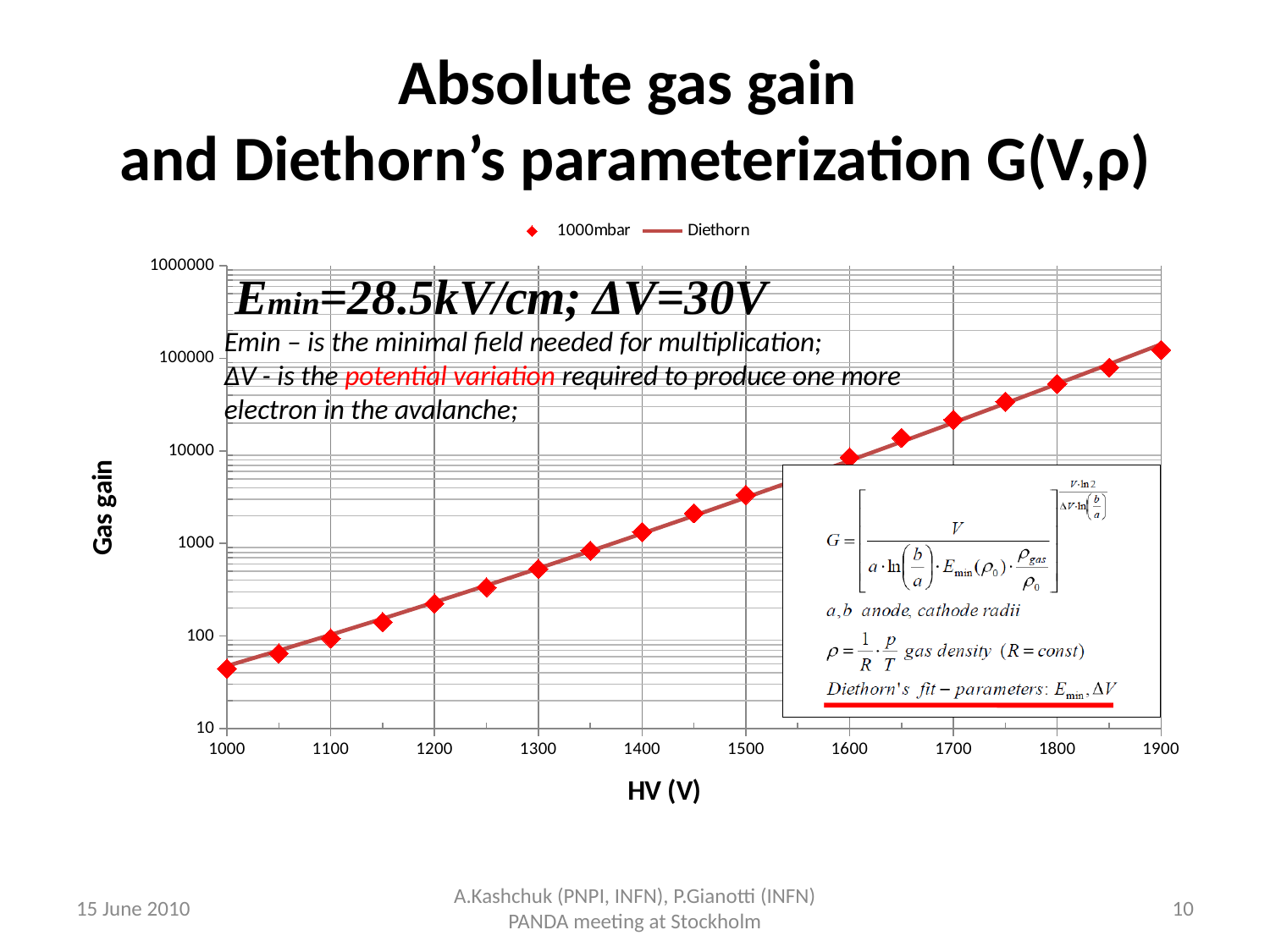
At which HV value is the gas gain lowest? 1000 How many series does the chart legend list? 2 What kind of chart is shown on the slide? Scatter chart with a fitted line Is the gas gain at HV = 1800 V greater or less than 10000? greater What are the two entries in the chart legend? 1000mbar and Diethorn Is the gas gain at HV = 1000 V greater or less than 100? less How many 1000mbar data points are plotted on the chart? 19 Which has the larger gas gain, HV = 1400 V or HV = 1200 V? 1400 V Does the gas gain rise or fall as HV increases along the x axis? Rises At which HV value is the gas gain highest? 1900 Is the gas gain at HV = 1500 V greater or less than 1000? greater What is the title of the chart's vertical axis? Gas gain